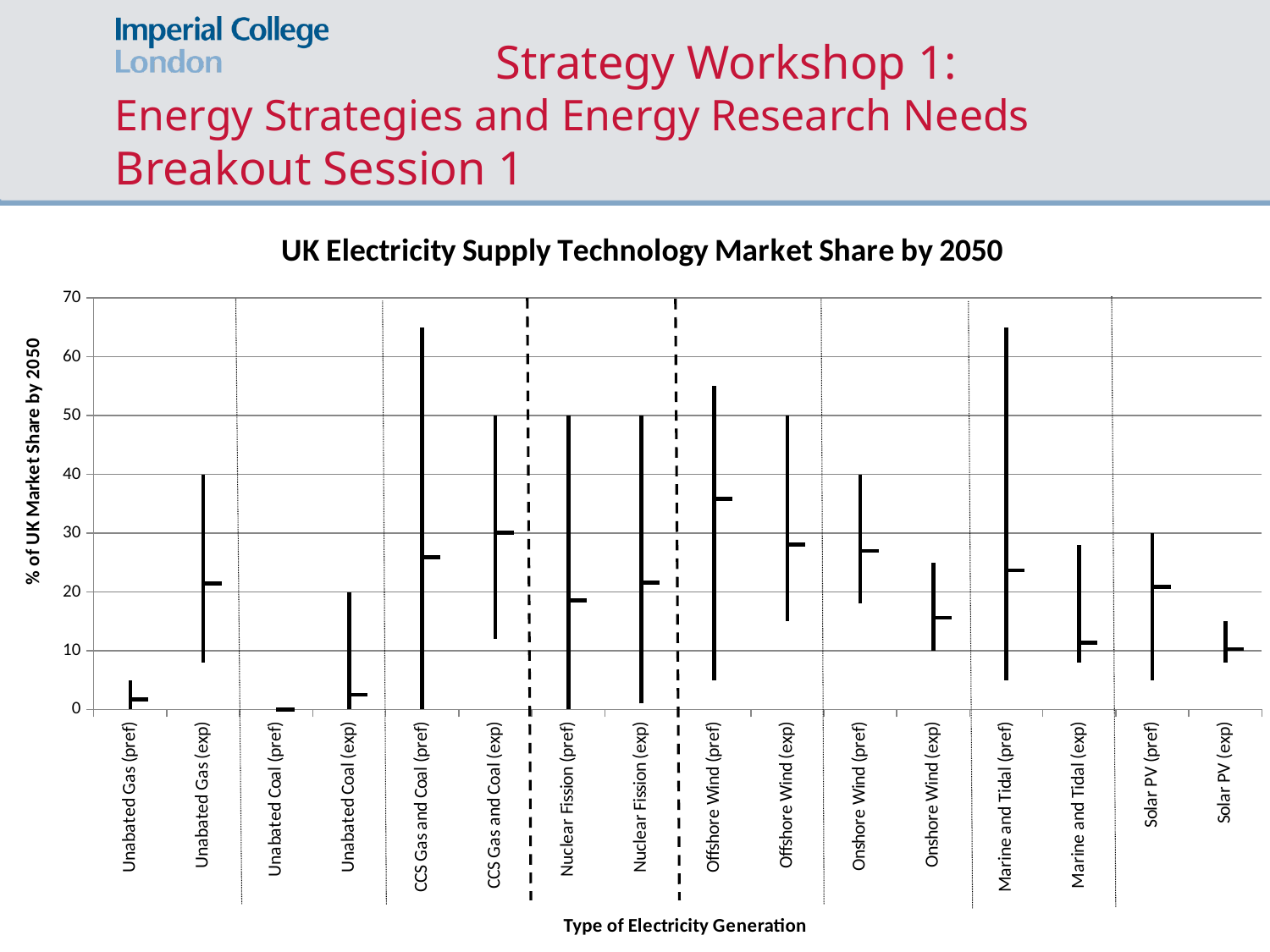
Which has the larger marker value, Offshore Wind (pref) or Onshore Wind (pref)? Offshore Wind (pref) Is the top of the range for Marine and Tidal (pref) greater or less than 60? greater What is the highest value shown on the vertical axis of the chart? 70 Is the marker value for Unabated Gas (pref) greater or less than 10? less Which category has the lowest marker (central tick) value on the chart? Unabated Coal (pref) How many categories are shown along the x axis of the chart? 16 What is the label on the vertical axis of the chart? % of UK Market Share by 2050 Which category has the highest marker (central tick) value on the chart? Offshore Wind (pref) Is the marker value for Onshore Wind (exp) greater or less than 20? less What is the title of the chart? UK Electricity Supply Technology Market Share by 2050 Which has the larger marker value, Unabated Gas (exp) or Unabated Coal (exp)? Unabated Gas (exp)